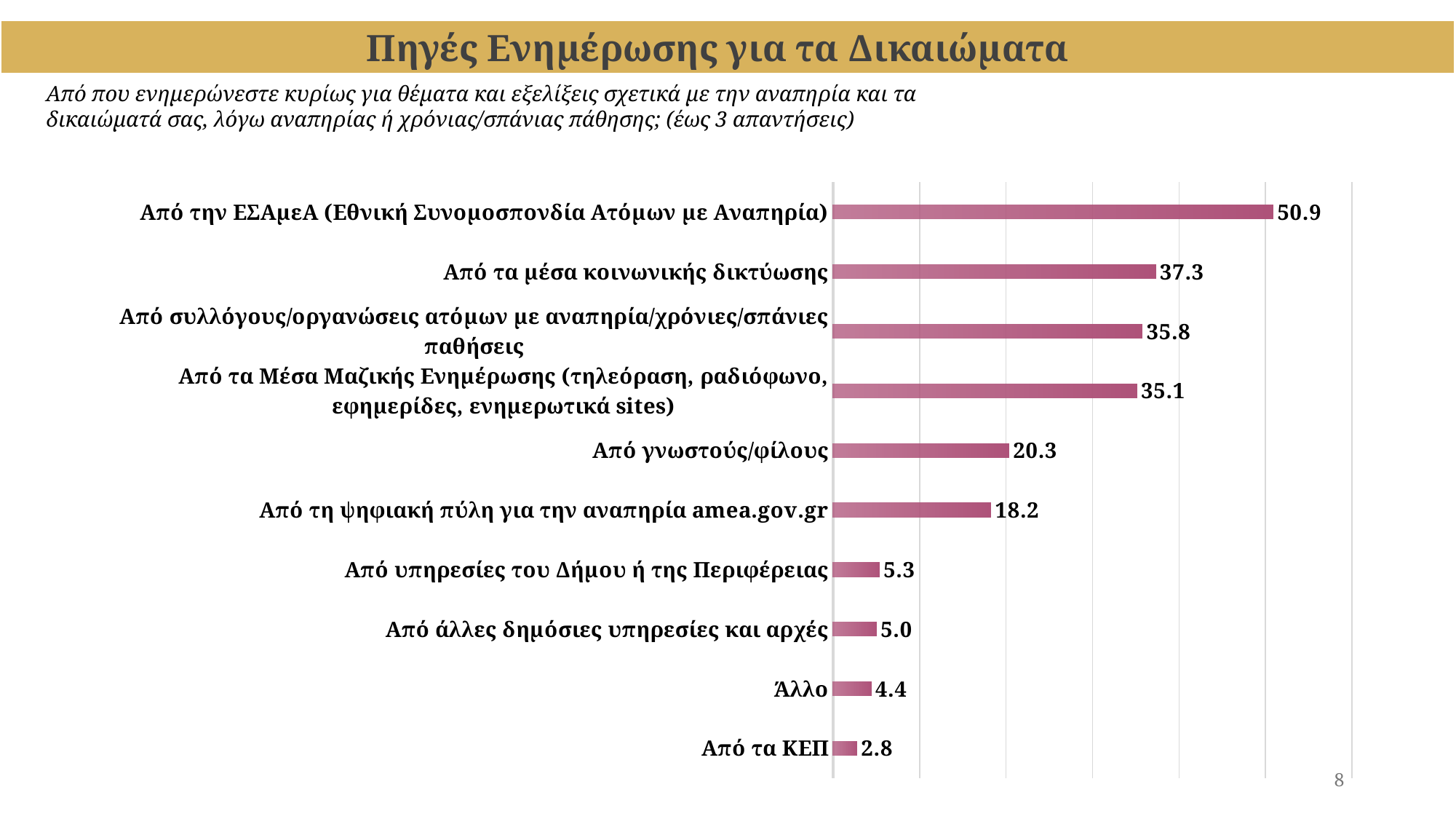
What is the difference between the values for "Από την ΕΣΑμεΑ (Εθνική Συνομοσπονδία Ατόμων με Αναπηρία)" and "Από τα μέσα κοινωνικής δικτύωσης"? 13.6 What value is shown for "Από τη ψηφιακή πύλη για την αναπηρία amea.gov.gr"? 18.2 What value is shown for "Από τα μέσα κοινωνικής δικτύωσης"? 37.3 Which category has the lowest value? Από τα ΚΕΠ Which category has the highest value? Από την ΕΣΑμεΑ (Εθνική Συνομοσπονδία Ατόμων με Αναπηρία) What value is shown for "Από τα ΚΕΠ"? 2.8 What kind of chart is shown on the slide? Bar chart What is the difference between the values for "Από γνωστούς/φίλους" and "Από τη ψηφιακή πύλη για την αναπηρία amea.gov.gr"? 2.1 Which is larger: the value for "Από υπηρεσίες του Δήμου ή της Περιφέρειας" or the value for "Άλλο"? Από υπηρεσίες του Δήμου ή της Περιφέρειας How many categories are shown in the chart? 10 What value is shown for "Από την ΕΣΑμεΑ (Εθνική Συνομοσπονδία Ατόμων με Αναπηρία)"? 50.9 What is the title of the slide? Πηγές Ενημέρωσης για τα Δικαιώματα